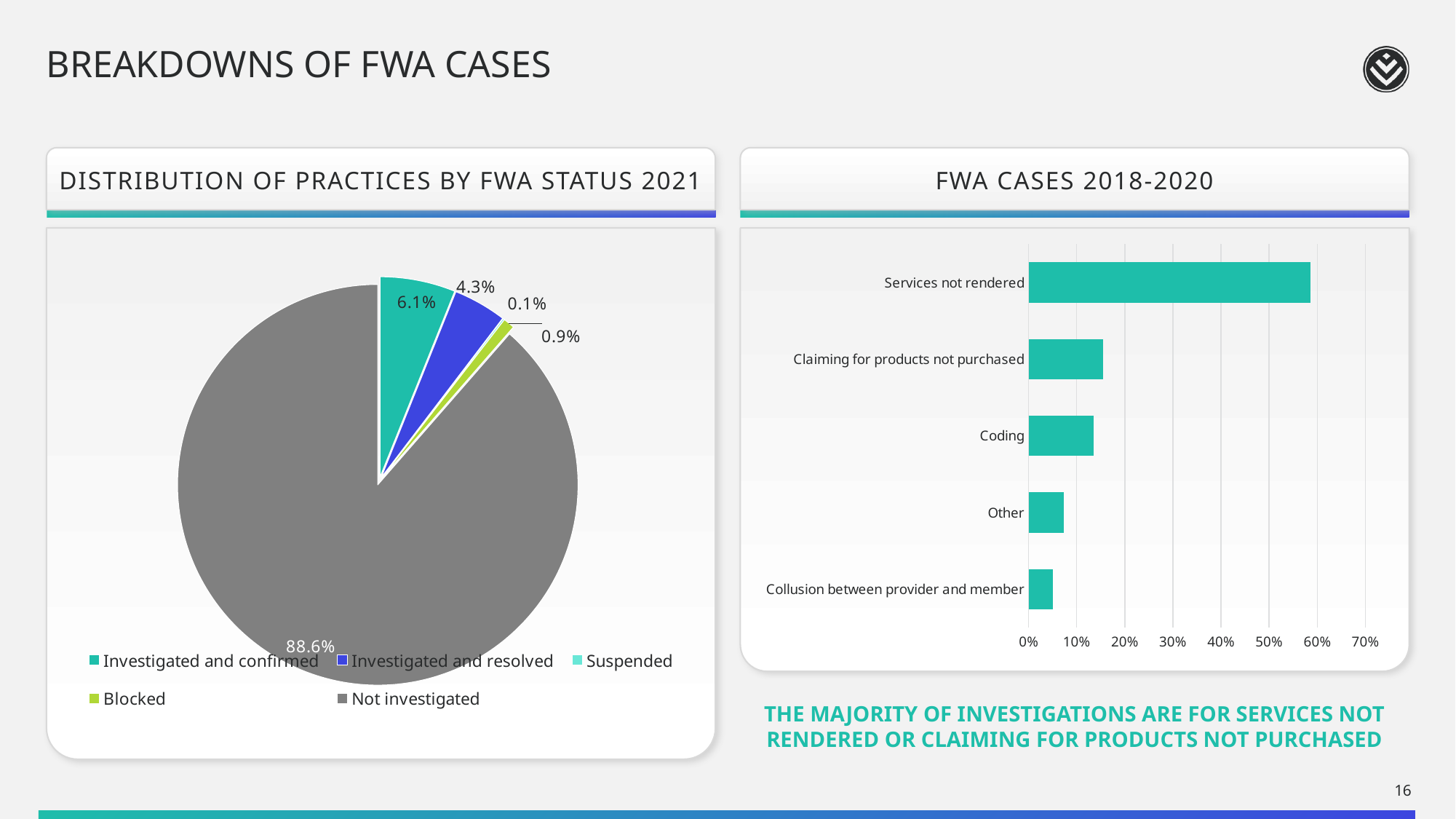
What kind of chart is 'Distribution of practices by FWA status 2021'? Pie chart In the pie chart 'Distribution of practices by FWA status 2021', which category has the smallest slice? Suspended In the pie chart 'Distribution of practices by FWA status 2021', how much larger is the Investigated and confirmed share than the Investigated and resolved share? 1.8% In the chart 'FWA cases 2018-2020', which category has the lowest value? Collusion between provider and member In the pie chart 'Distribution of practices by FWA status 2021', what is the value for Investigated and confirmed? 6.1% In the chart 'FWA cases 2018-2020', which is larger, Coding or Other? Coding In the pie chart 'Distribution of practices by FWA status 2021', what percentage of practices were Not investigated? 88.6% What kind of chart is 'FWA cases 2018-2020'? Bar chart In the chart 'FWA cases 2018-2020', which category has the highest value? Services not rendered In the pie chart 'Distribution of practices by FWA status 2021', which category has the largest slice? Not investigated In the pie chart 'Distribution of practices by FWA status 2021', how many categories does the legend list? 5 In the chart 'FWA cases 2018-2020', is the value for Services not rendered greater or less than 50%? greater